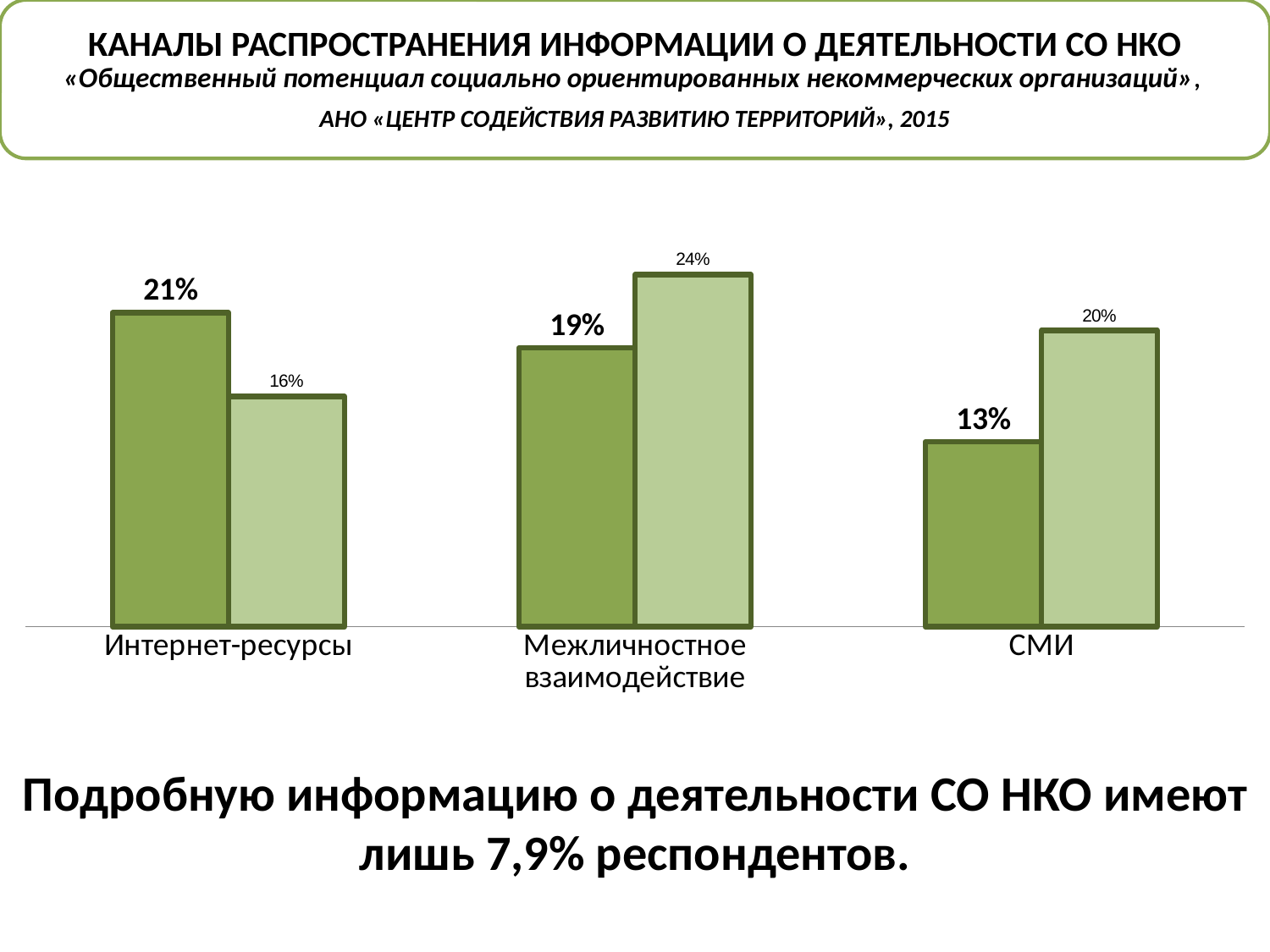
How many categories are shown on the x axis of the chart? 3 What kind of chart is shown on the slide? bar chart For Межличностное взаимодействие, which bar is larger, the dark green or the light green? light green Which category has the highest light green bar? Межличностное взаимодействие What is the value of the light green bar for Интернет-ресурсы? 16% How many bars are shown for each category in the chart? 2 Which category has the highest dark green bar? Интернет-ресурсы What is the value of the dark green bar for Интернет-ресурсы? 21% What is the value of the dark green bar for Межличностное взаимодействие? 19% What is the difference between the light green and dark green bars for СМИ? 7% Which category has the lowest dark green bar? СМИ What is the value of the light green bar for СМИ? 20%